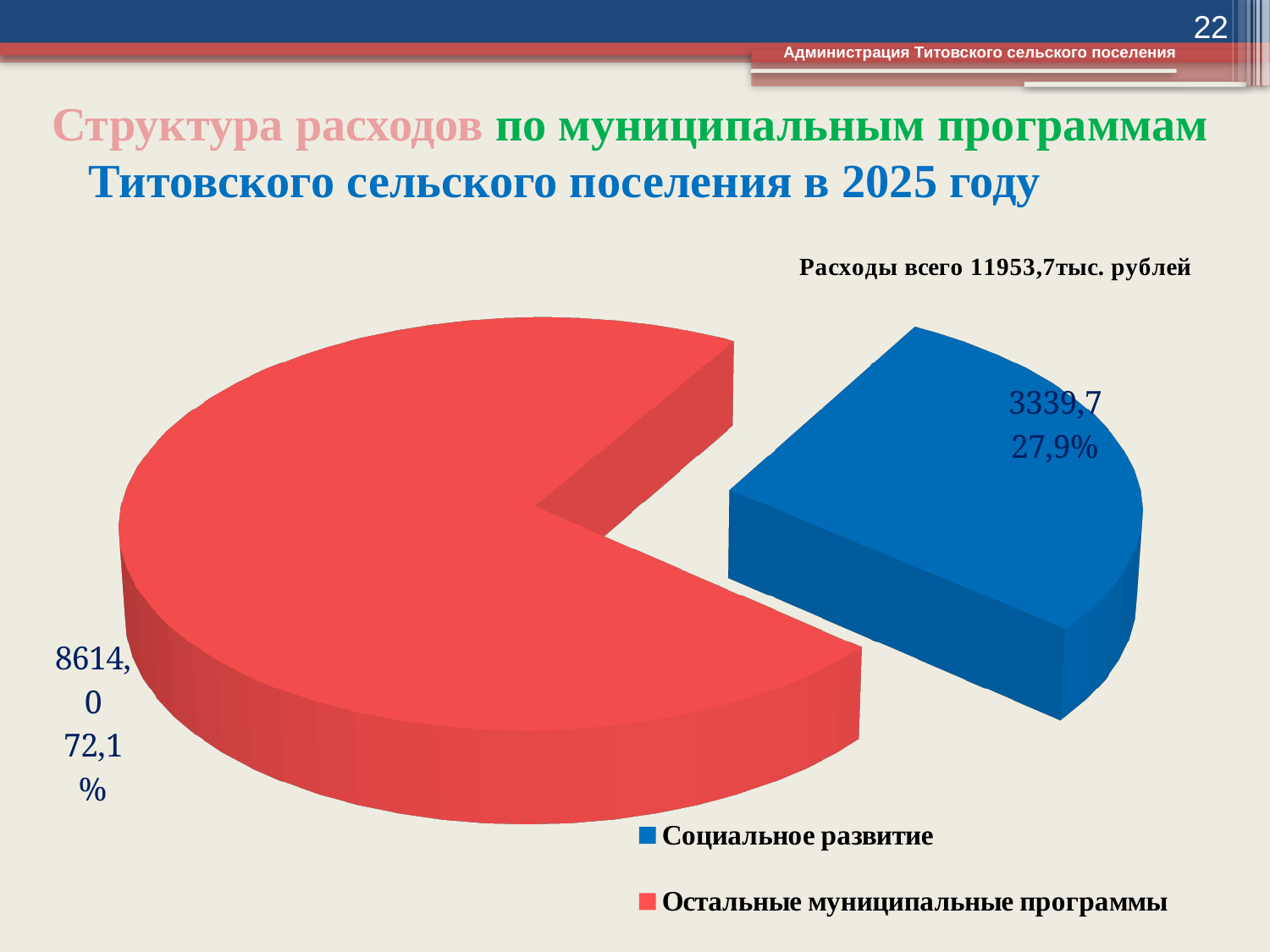
What share of the pie does Остальные муниципальные программы take? 72,1% What is the difference between the values for Остальные муниципальные программы and Социальное развитие? 5274,3 Which slice is the largest? Остальные муниципальные программы How many slices does the pie chart have? 2 Which is larger, Социальное развитие or Остальные муниципальные программы? Остальные муниципальные программы What share of the pie does Социальное развитие take? 27,9% What kind of chart is shown on the slide? pie chart What total expenditure is stated above the chart? 11953,7 тыс. рублей What is the value for Остальные муниципальные программы? 8614,0 What colour is the slice for Социальное развитие? blue What is the value for Социальное развитие? 3339,7 Which slice is the smallest? Социальное развитие